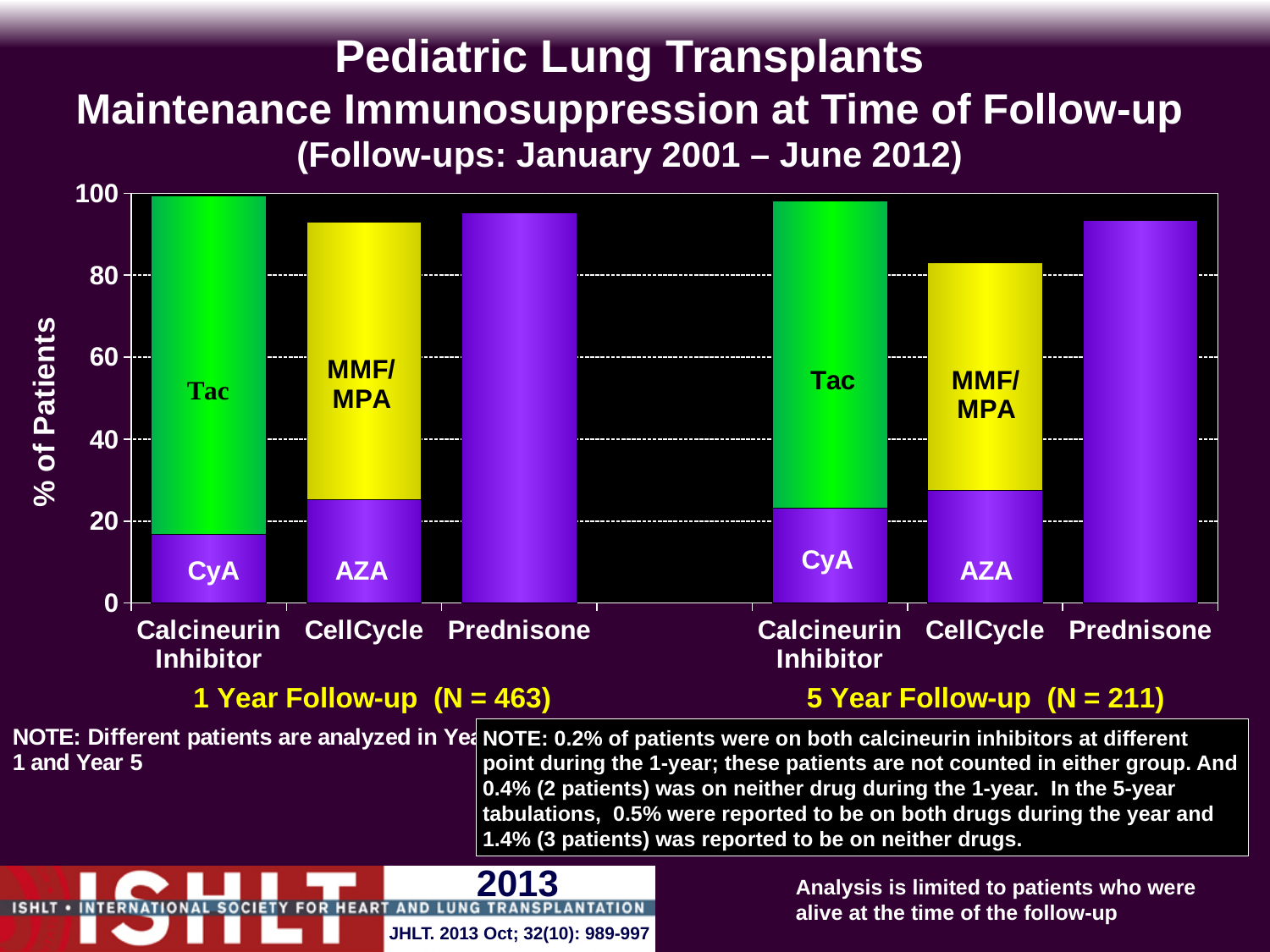
In the 5 Year Follow-up CellCycle bar, which segment is larger, MMF/MPA or AZA? MMF/MPA Which drug is represented by the yellow segments in the chart? MMF/MPA In the 1 Year Follow-up group, is the value for Prednisone greater or less than 80? greater What is the N for the 1 Year Follow-up group? 463 In the 5 Year Follow-up group, is the total value for Calcineurin Inhibitor greater or less than 80? greater In the 5 Year Follow-up group, is the total value for CellCycle greater or less than 90? less How many drug categories are shown on the x axis for the 1 Year Follow-up group? 3 In the 1 Year Follow-up Calcineurin Inhibitor bar, which segment is larger, Tac or CyA? Tac What kind of chart is shown on the slide? bar chart Which is larger, the total CellCycle bar in the 1 Year Follow-up group or in the 5 Year Follow-up group? 1 Year Follow-up